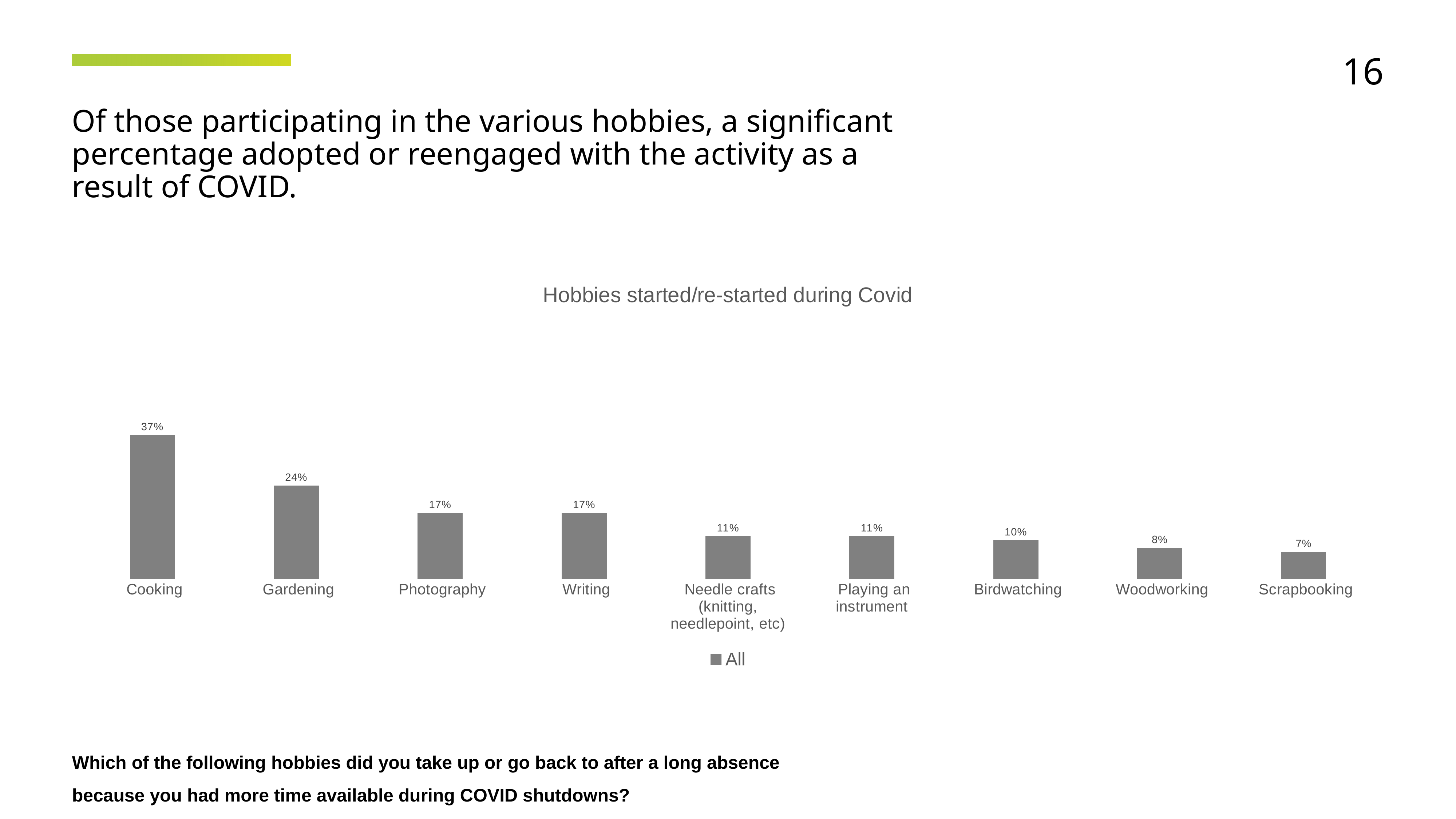
How many series does the legend list? 1 What is the value for Gardening? 24% What is the difference between the values for Cooking and Gardening? 13% How many hobbies are shown on the x axis? 9 What kind of chart is shown? Bar chart What is the value for Scrapbooking? 7% Which hobby has the lowest value? Scrapbooking What is the value for Cooking? 37% What is the value for Birdwatching? 10% Which is larger, the value for Woodworking or the value for Birdwatching? Birdwatching Which hobby has the highest value? Cooking What is the title of the chart? Hobbies started/re-started during Covid